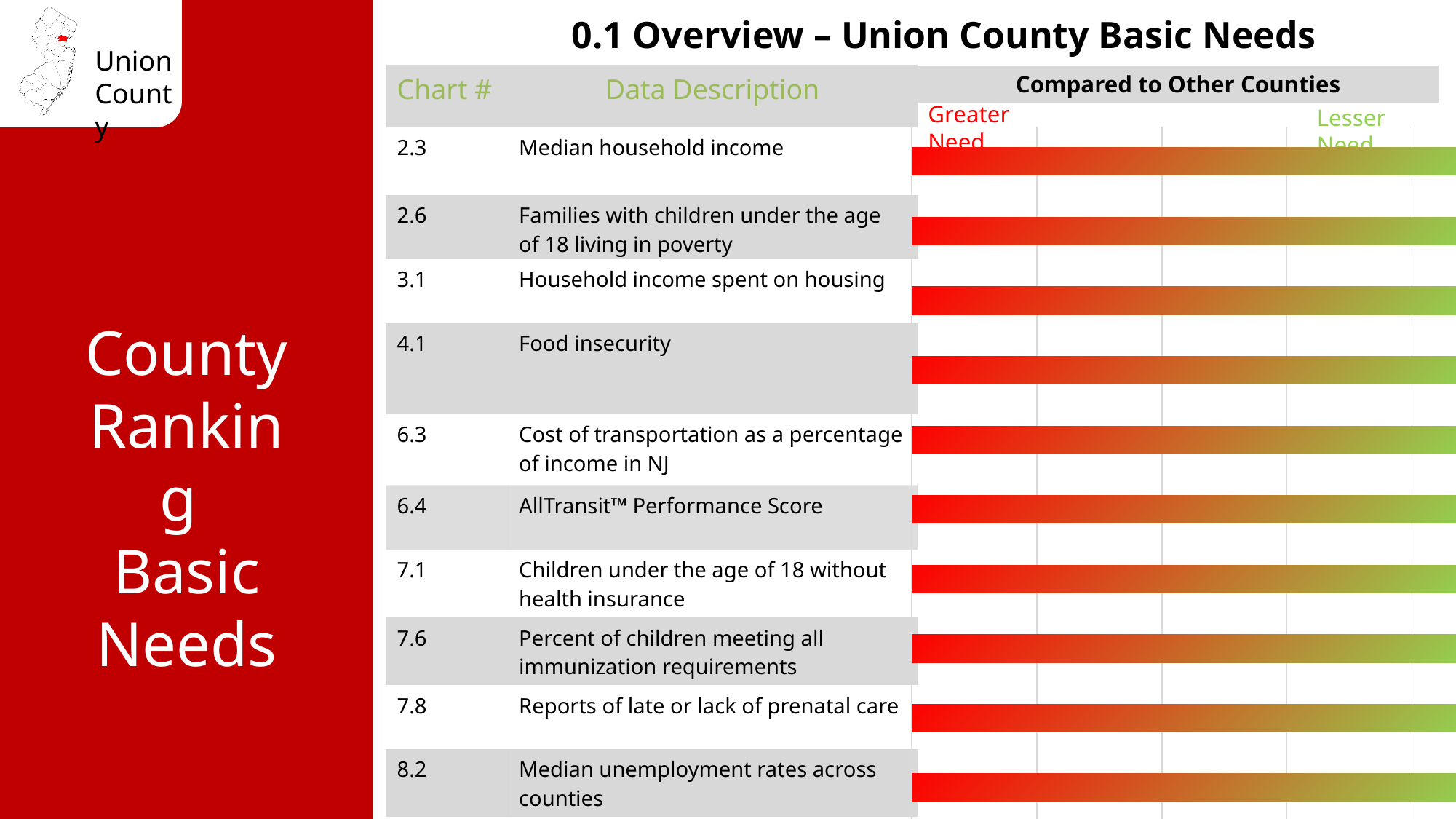
What is the data description for chart 7.8? Reports of late or lack of prenatal care How many data description rows are listed in the County Ranking Basic Needs table? 10 What is the heading of the column containing the colored bars? Compared to Other Counties What label appears at the left (red) end of the comparison scale? Greater Need Which chart number corresponds to 'Food insecurity'? 4.1 Which chart number corresponds to 'Median household income'? 2.3 What kind of chart is used in the 'Compared to Other Counties' column? bar chart What is the data description for chart 6.4? AllTransit™ Performance Score Which chart number corresponds to 'Median unemployment rates across counties'? 8.2